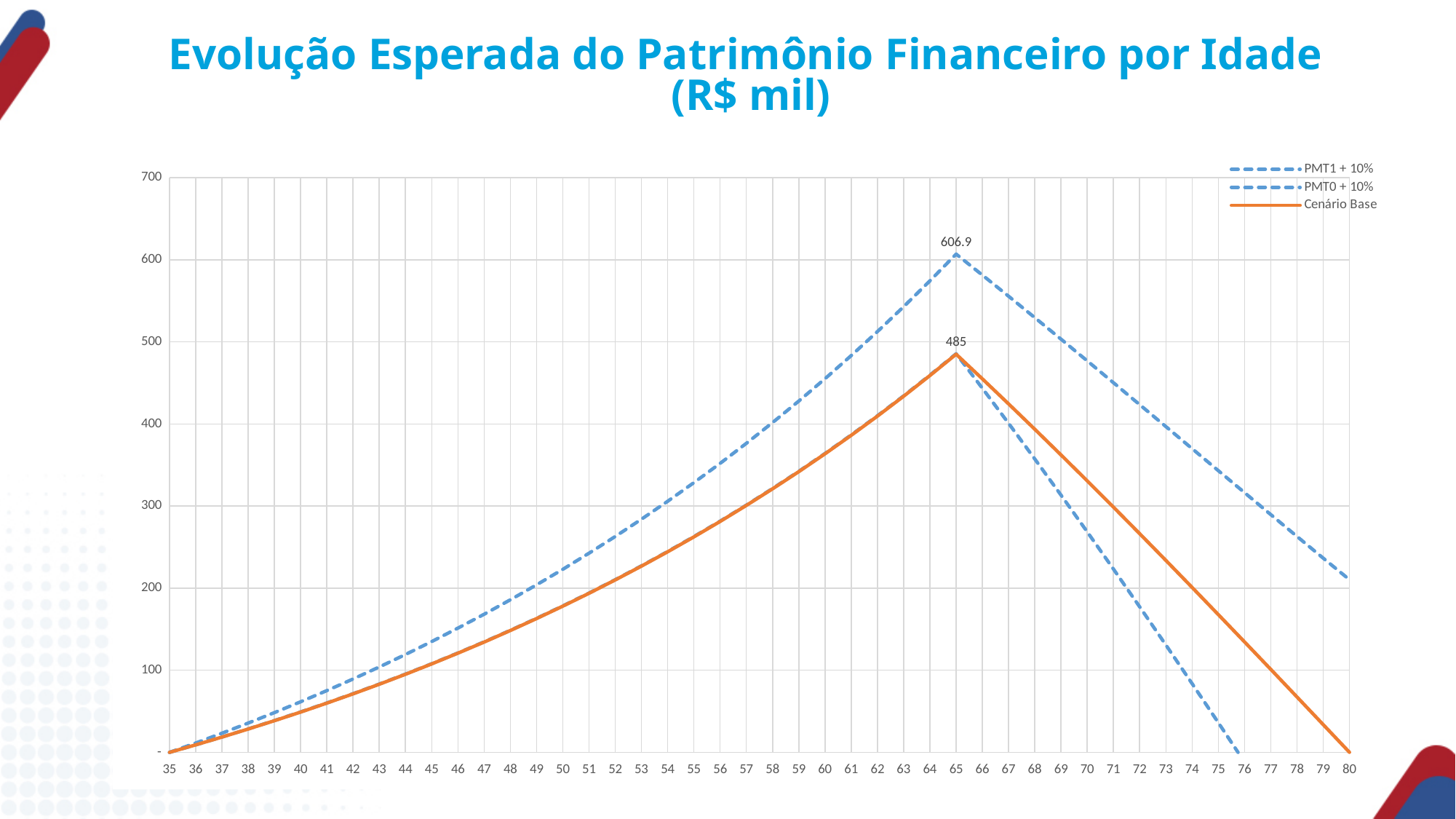
How many series does the legend list? 3 What is the title of the chart? Evolução Esperada do Patrimônio Financeiro por Idade (R$ mil) Is the value for PMT1 + 10% at age 80 greater or less than 300? less What is the labelled value of the Cenário Base series at age 65? 485 At which age does the Cenário Base series reach its highest value? 65 Does the Cenário Base series rise or fall between age 65 and age 80? fall What kind of chart is shown on the slide? line chart Is the value for Cenário Base at age 40 greater or less than 100? less